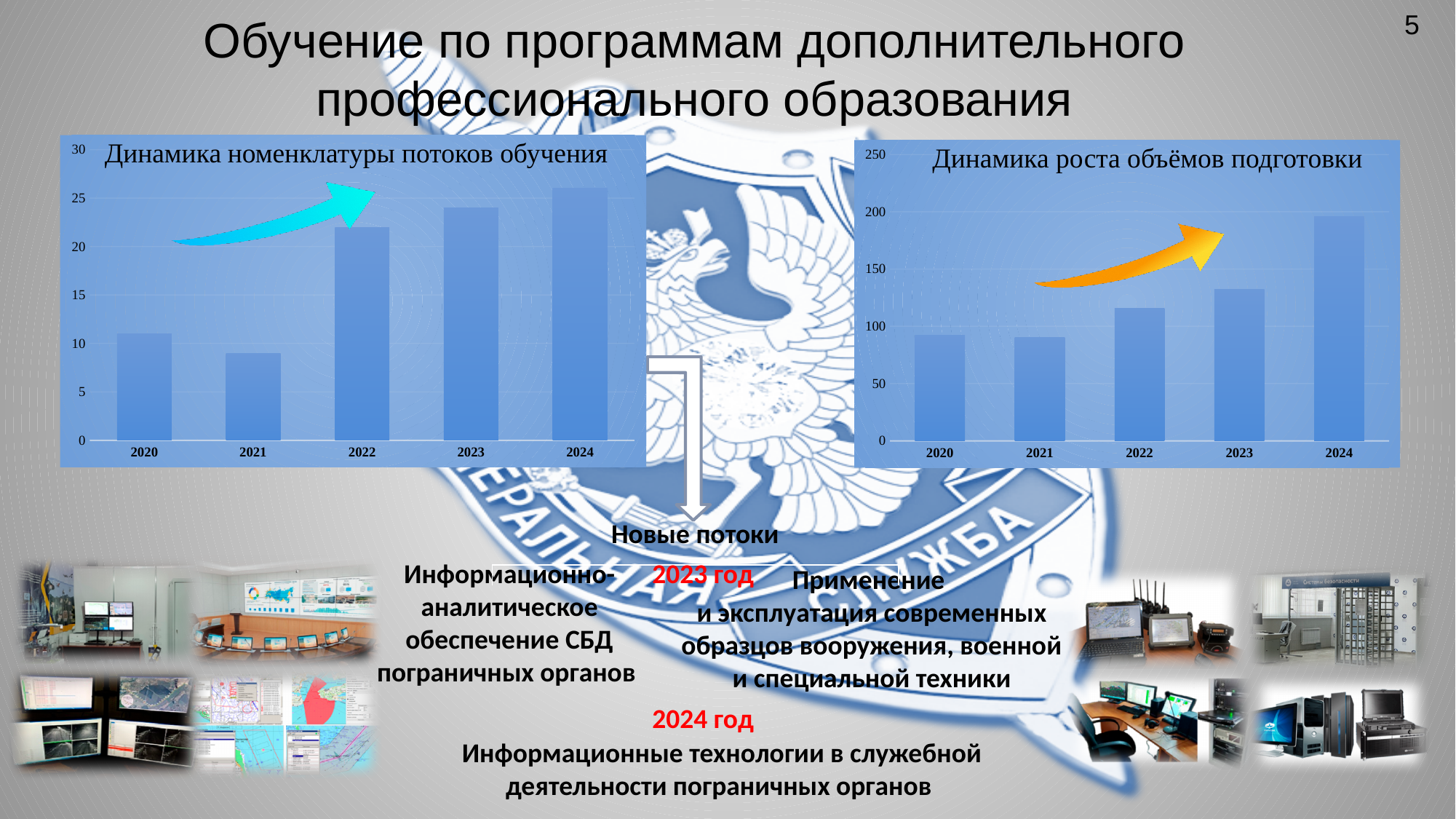
In the left chart "Динамика номенклатуры потоков обучения", which year has the lowest bar? 2021 What is the title of the right chart on the slide? Динамика роста объёмов подготовки In the right chart "Динамика роста объёмов подготовки", which is larger, the value for 2023 or the value for 2022? 2023 In the left chart "Динамика номенклатуры потоков обучения", how many years are shown on the x axis? 5 What kind of chart is the left chart titled "Динамика номенклатуры потоков обучения"? bar chart In the left chart "Динамика номенклатуры потоков обучения", is the value for 2022 greater or less than 20? greater In the left chart "Динамика номенклатуры потоков обучения", which year has the highest bar? 2024 In the left chart "Динамика номенклатуры потоков обучения", is the value for 2020 greater or less than 15? less In the right chart "Динамика роста объёмов подготовки", which year has the highest bar? 2024 In the right chart "Динамика роста объёмов подготовки", is the value for 2024 greater or less than 150? greater In the right chart "Динамика роста объёмов подготовки", do the values generally rise or fall from 2021 to 2024? rise